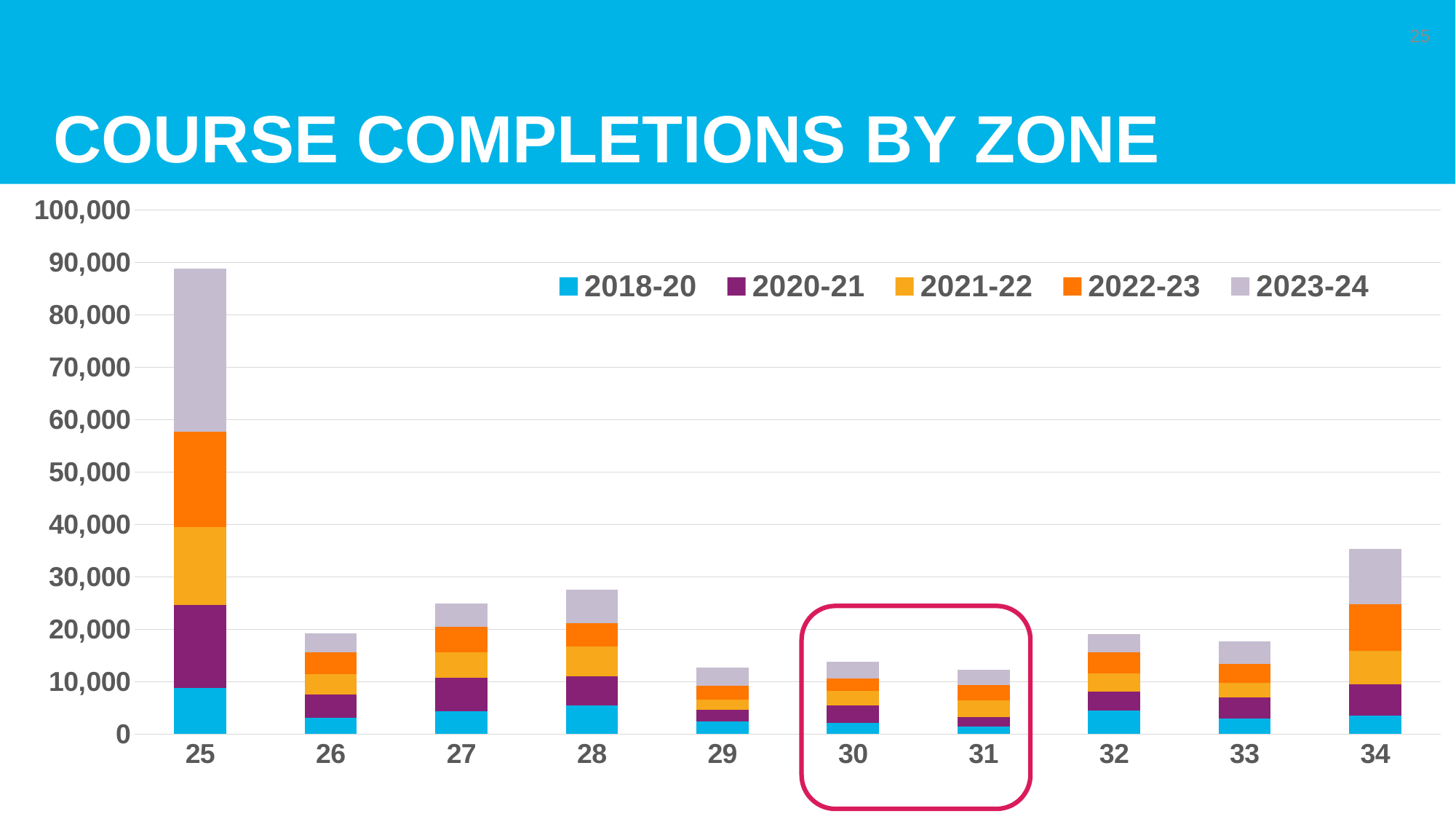
Which has the larger total, zone 27 or zone 32? 27 What kind of chart is shown on the slide? Stacked bar chart Is the total for zone 28 greater or less than 20,000? greater How many series does the legend list? 5 Is the total for zone 34 greater or less than 30,000? greater How many zones are shown on the x axis of the chart? 10 Which zones are highlighted by the red outlined box? 30 and 31 Is the total for zone 25 greater or less than 80,000? greater Which zone has the highest total course completions? 25 Which has the larger total, zone 34 or zone 28? 34 What is the title of the chart? COURSE COMPLETIONS BY ZONE